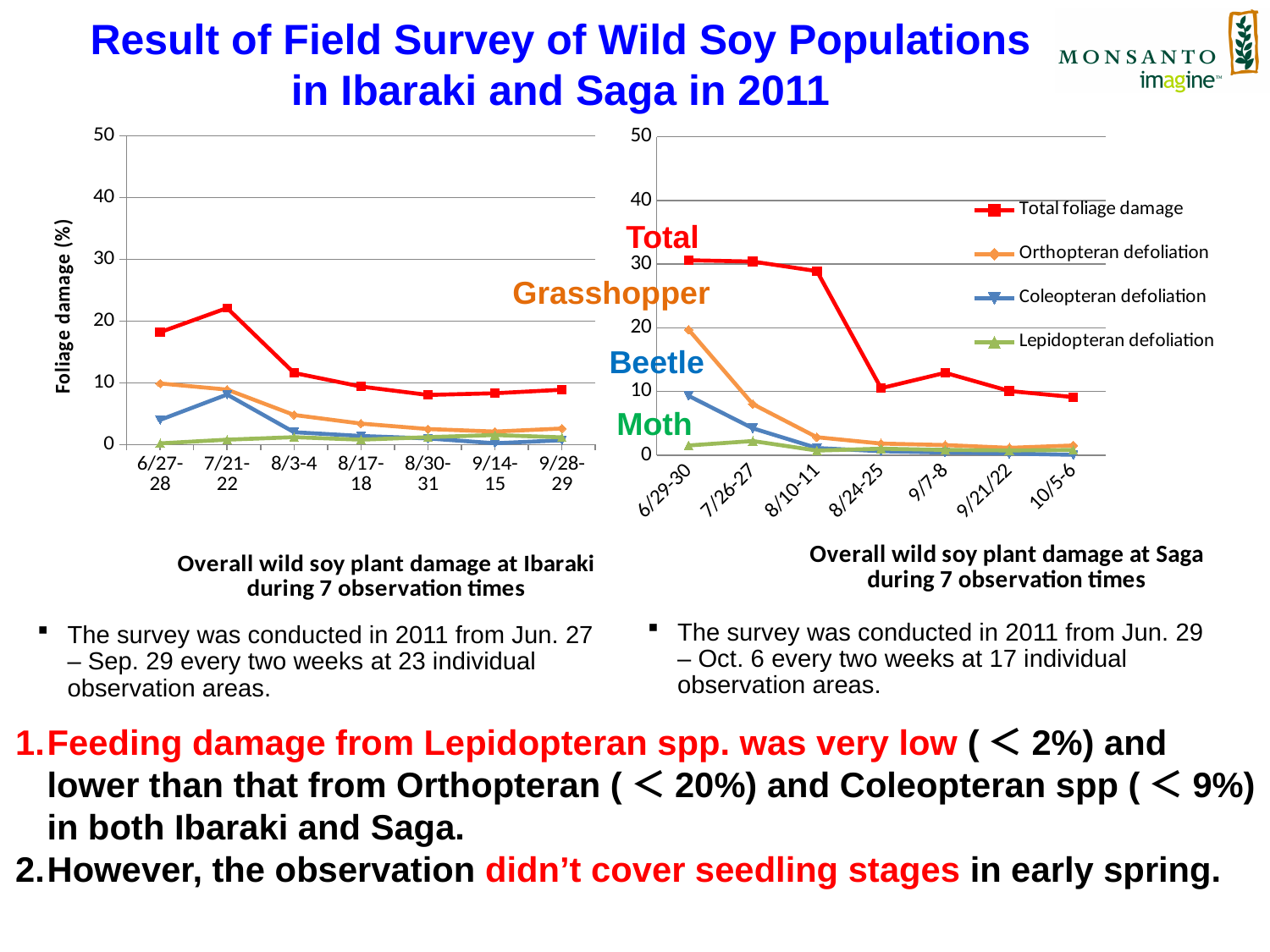
In the left chart (Ibaraki), is the Coleopteran defoliation at 7/21-22 greater or less than 10? less In the right chart (Saga), at which observation time is Orthopteran defoliation highest? 6/29-30 What type of chart is the left chart, 'Overall wild soy plant damage at Ibaraki during 7 observation times'? Line chart What is the label of the y axis on the left chart (Ibaraki)? Foliage damage (%) How many series does the legend on the right chart (Saga) list? 4 In the right chart (Saga), does Total foliage damage generally rise or fall from 6/29-30 to 10/5-6? fall In the left chart (Ibaraki), is the Total foliage damage at 7/21-22 greater or less than 20? greater How many observation times are shown on the x axis of the left chart (Ibaraki)? 7 In the left chart (Ibaraki), at which observation time is Total foliage damage highest? 7/21-22 In the right chart (Saga), is the Total foliage damage at 8/24-25 greater or less than 20? less In the right chart (Saga), at 6/29-30, which is larger: Orthopteran defoliation or Coleopteran defoliation? Orthopteran defoliation